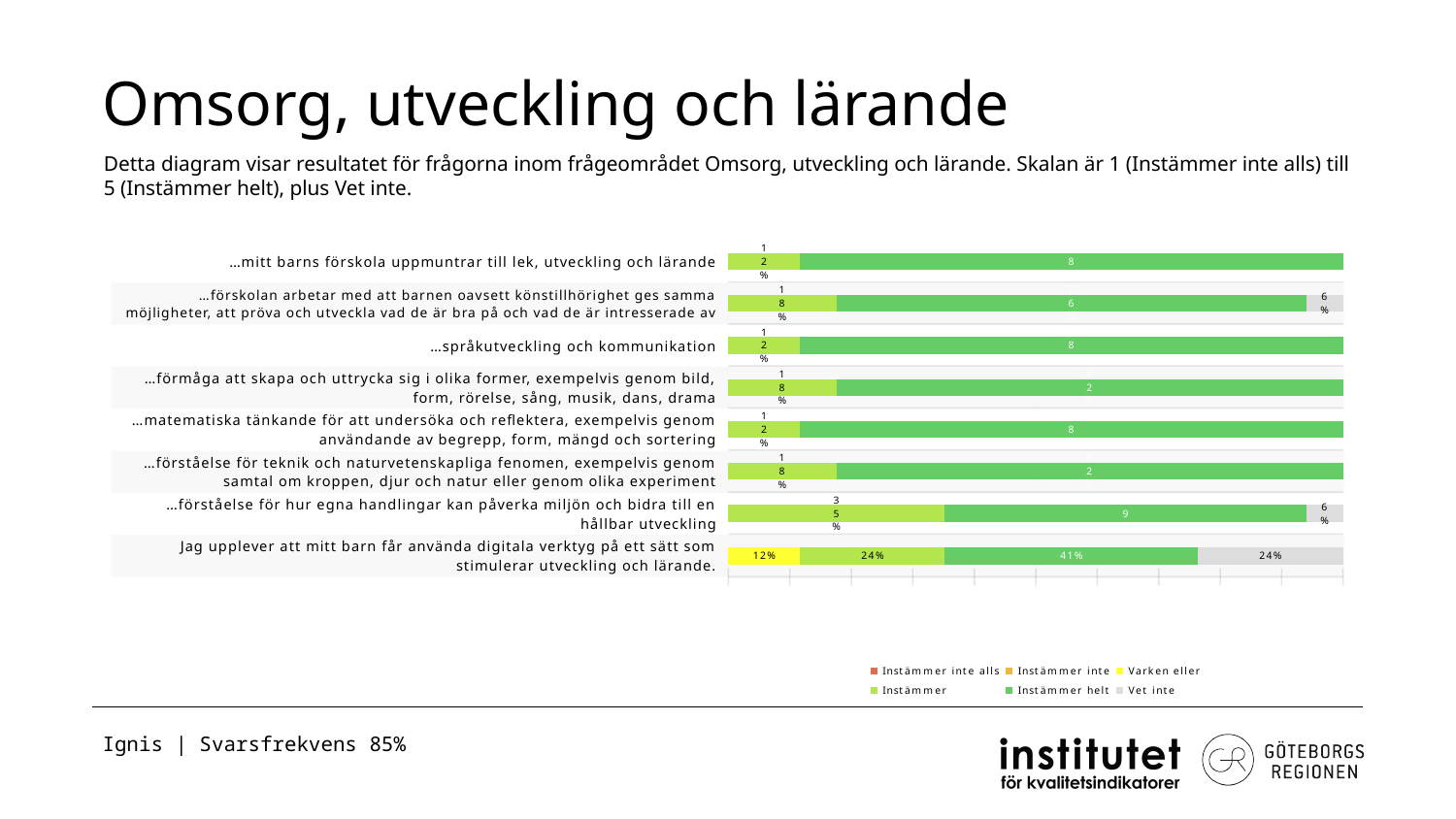
For the statement "Jag upplever att mitt barn får använda digitala verktyg på ett sätt som stimulerar utveckling och lärande.", what is the value for Vet inte? 24% For the statement about digitala verktyg, which response category has the highest share? Instämmer helt How many question statements (categories) are plotted in the chart? 8 For the statement "Jag upplever att mitt barn får använda digitala verktyg på ett sätt som stimulerar utveckling och lärande.", what is the value for Varken eller? 12% Which statement has the largest Vet inte (grey) segment? Jag upplever att mitt barn får använda digitala verktyg på ett sätt som stimulerar utveckling och lärande. How many series does the chart legend list? 6 For the statement about digitala verktyg, what is the difference between Instämmer helt (41%) and Instämmer (24%)? 17% For the statement about digitala verktyg, which is larger: Instämmer helt or Vet inte? Instämmer helt What is the title of the slide containing the chart? Omsorg, utveckling och lärande Which legend entry is shown in grey? Vet inte For the statement "Jag upplever att mitt barn får använda digitala verktyg på ett sätt som stimulerar utveckling och lärande.", what is the value for Instämmer helt? 41% What kind of chart is shown on the slide? Bar chart